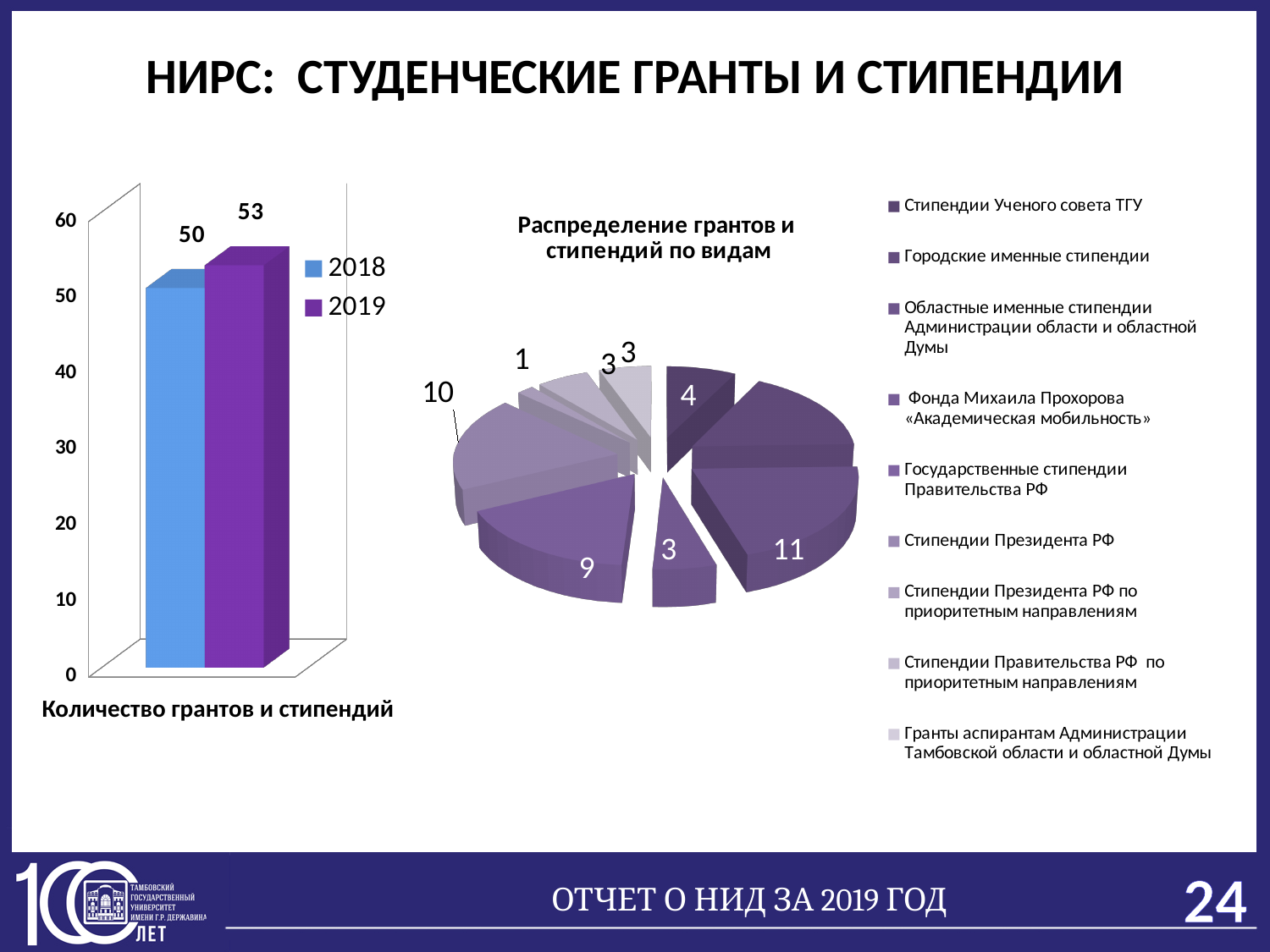
On the pie chart 'Распределение грантов и стипендий по видам', what is the value of the smallest labelled slice? 1 What kind of chart is 'Количество грантов и стипендий'? bar chart On the bar chart 'Количество грантов и стипендий', how many series does the legend list? 2 On the bar chart 'Количество грантов и стипендий', what is the value for 2018? 50 On the pie chart 'Распределение грантов и стипендий по видам', how many entries does the legend list? 9 On the pie chart 'Распределение грантов и стипендий по видам', what is the value of the largest slice? 11 On the bar chart 'Количество грантов и стипендий', do the values rise or fall from 2018 to 2019? rise What kind of chart is 'Распределение грантов и стипендий по видам'? pie chart On the bar chart 'Количество грантов и стипендий', by how much does the 2019 value exceed the 2018 value? 3 On the bar chart 'Количество грантов и стипендий', which year has the higher value, 2018 or 2019? 2019 On the bar chart 'Количество грантов и стипендий', what is the value for 2019? 53 On the bar chart 'Количество грантов и стипендий', what is the highest value shown on the vertical axis? 60